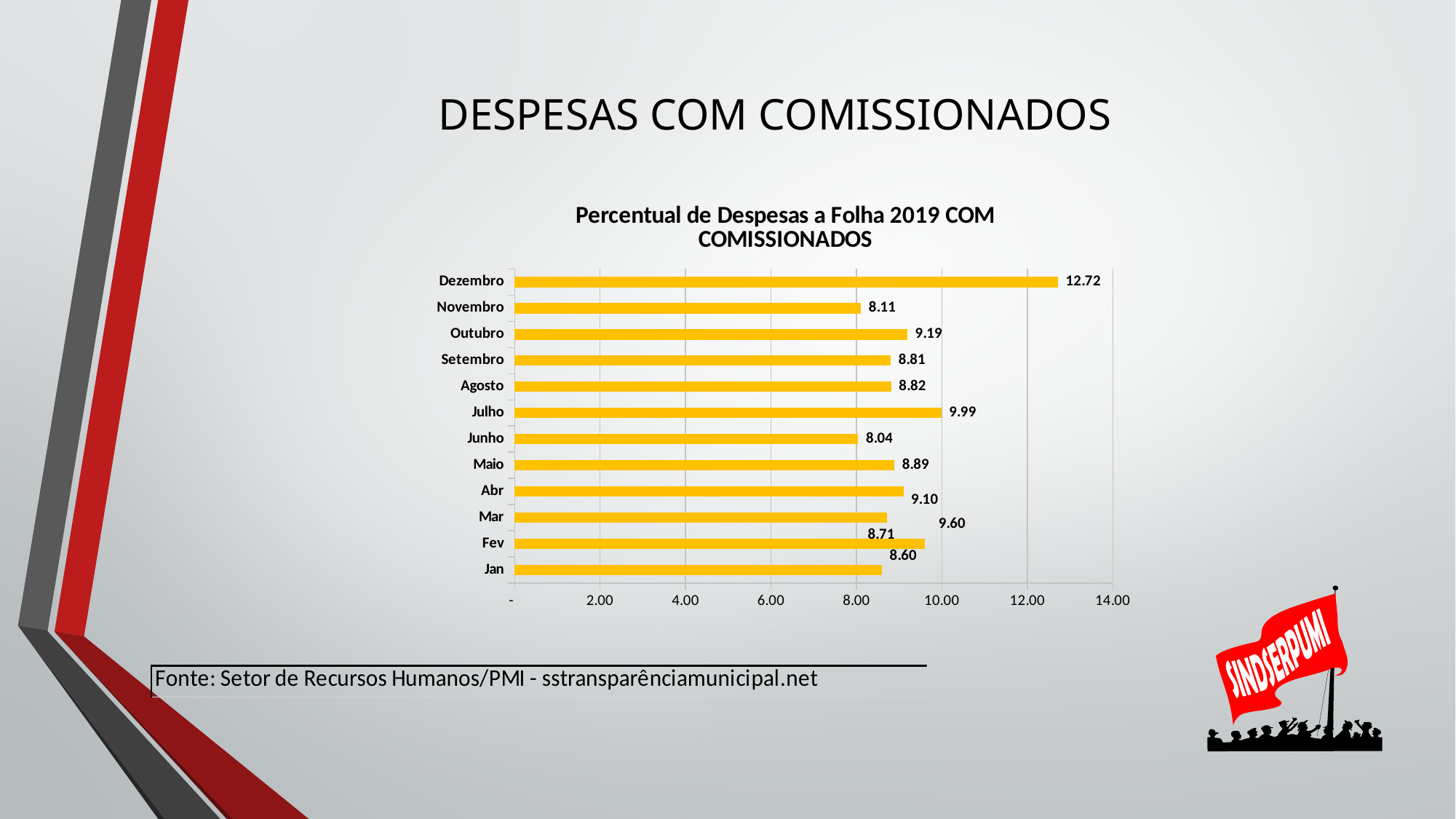
What is the value for Junho? 8.04 Is the value for Dezembro greater or less than 12.00? greater What is the value for Dezembro? 12.72 What is the difference between the values for Dezembro and Novembro? 4.61 Which month has the lowest value? Junho What is the title of the chart? Percentual de Despesas a Folha 2019 COM COMISSIONADOS Which month has the highest value? Dezembro How many months are shown in the chart? 12 Which is larger, the value for Julho or the value for Agosto? Julho What is the value for Julho? 9.99 What is the value for Outubro? 9.19 What kind of chart is shown on the slide? Bar chart